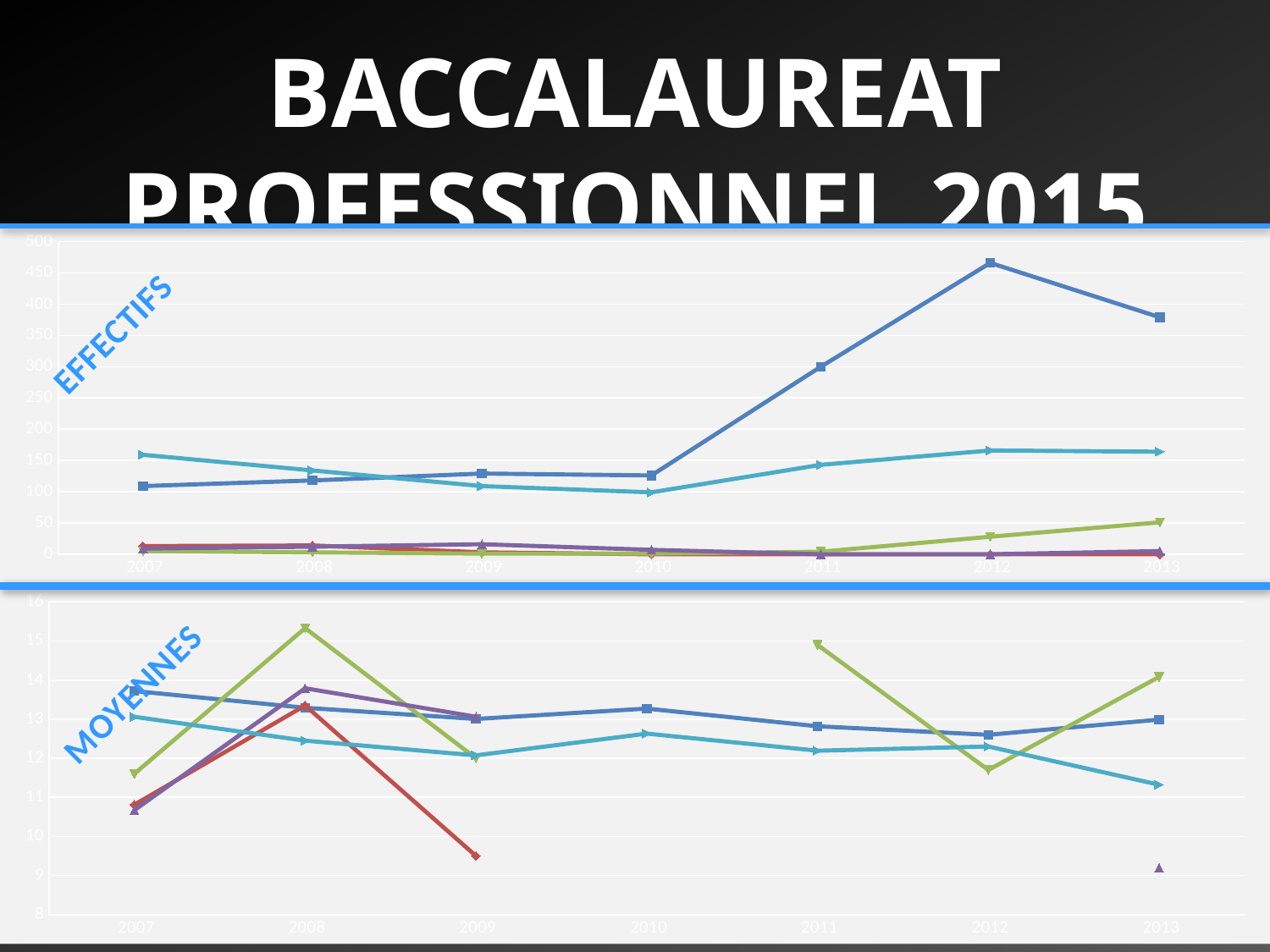
In the EFFECTIFS chart, which line has the larger value in 2012, the dark blue line or the teal line? the dark blue line In the EFFECTIFS chart, does the dark blue line rise or fall between 2010 and 2012? rise In the MOYENNES chart, in which year does the green line reach its highest value? 2008 In the MOYENNES chart, is the value of the green line in 2008 greater or less than 15? greater What kind of chart is the top chart labelled EFFECTIFS? line chart In the MOYENNES chart, is the value of the red line in 2009 greater or less than 10? less What is the label of the bottom chart on the slide? MOYENNES In the EFFECTIFS chart, in which year does the dark blue line reach its highest value? 2012 In the MOYENNES chart, does the teal line rise or fall between 2010 and 2013? fall In the EFFECTIFS chart, how many years are shown on the x axis? 7 In the EFFECTIFS chart, is the value of the dark blue line in 2013 greater or less than 400? less